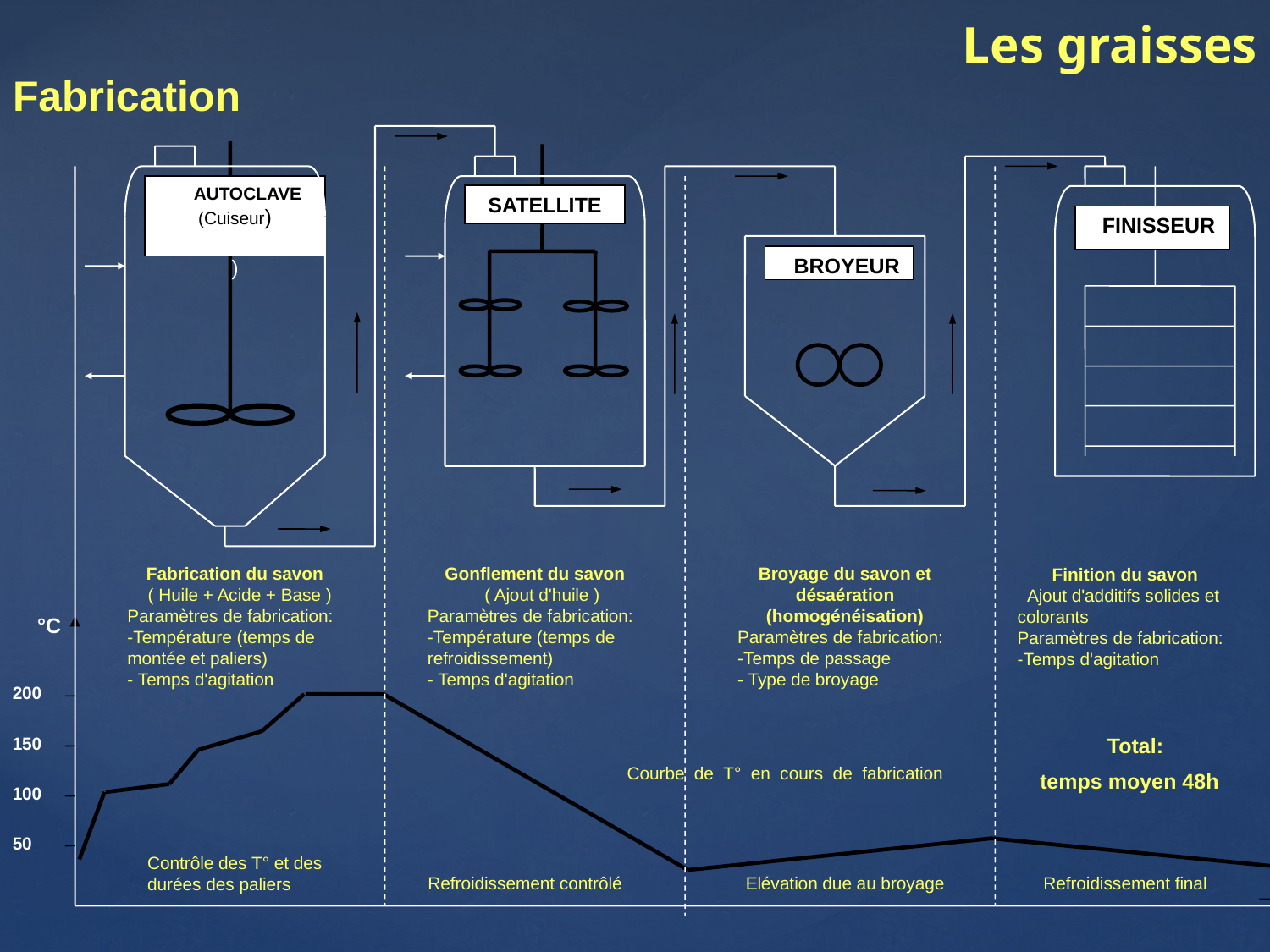
How many labelled phases does the temperature curve pass through along the x axis? 4 What is the title of the temperature curve shown on the slide? Courbe de T° en cours de fabrication Is the peak temperature reached during the first phase ('Contrôle des T° et des durées des paliers') greater or less than 150? greater Is the temperature at the end of the 'Refroidissement contrôlé' phase greater or less than 50? less Does the temperature curve rise or fall during the 'Elévation due au broyage' phase? rise What kind of chart is the temperature curve at the bottom of the slide? line chart Does the temperature curve rise or fall during the 'Refroidissement contrôlé' phase? fall In which phase does the temperature curve reach its highest value? Contrôle des T° et des durées des paliers Does the temperature curve rise or fall during the 'Refroidissement final' phase? fall What unit is shown on the y axis of the temperature curve? °C How many tick values are labelled on the y axis of the temperature curve? 4 What is the highest tick value labelled on the y axis of the temperature curve? 200